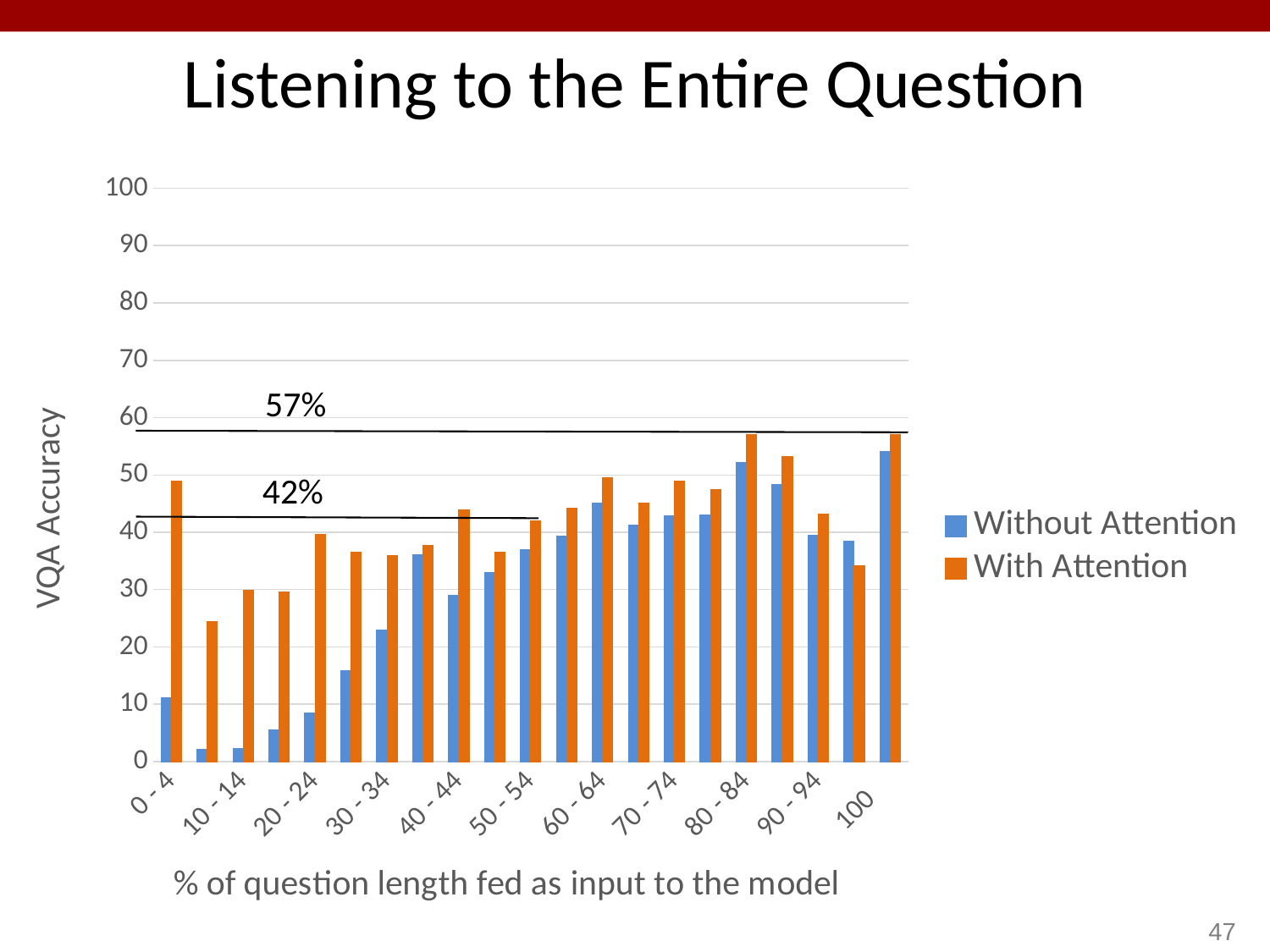
What kind of chart is shown on the slide? bar chart Which series has the larger value for the 0 - 4 category, Without Attention or With Attention? With Attention Is the Without Attention value for the 100 category greater or less than 50? greater How many series does the legend list? 2 What are the two series named in the legend? Without Attention, With Attention Is the With Attention value for the 0 - 4 category greater or less than 40? greater Is the Without Attention value for the 10 - 14 category greater or less than 10? less For which category is the Without Attention value highest? 100 Which series has the larger value for the 90 - 94 category, Without Attention or With Attention? With Attention Do the Without Attention values generally rise or fall as the % of question length increases? rise What is the title of the chart on the slide? Listening to the Entire Question